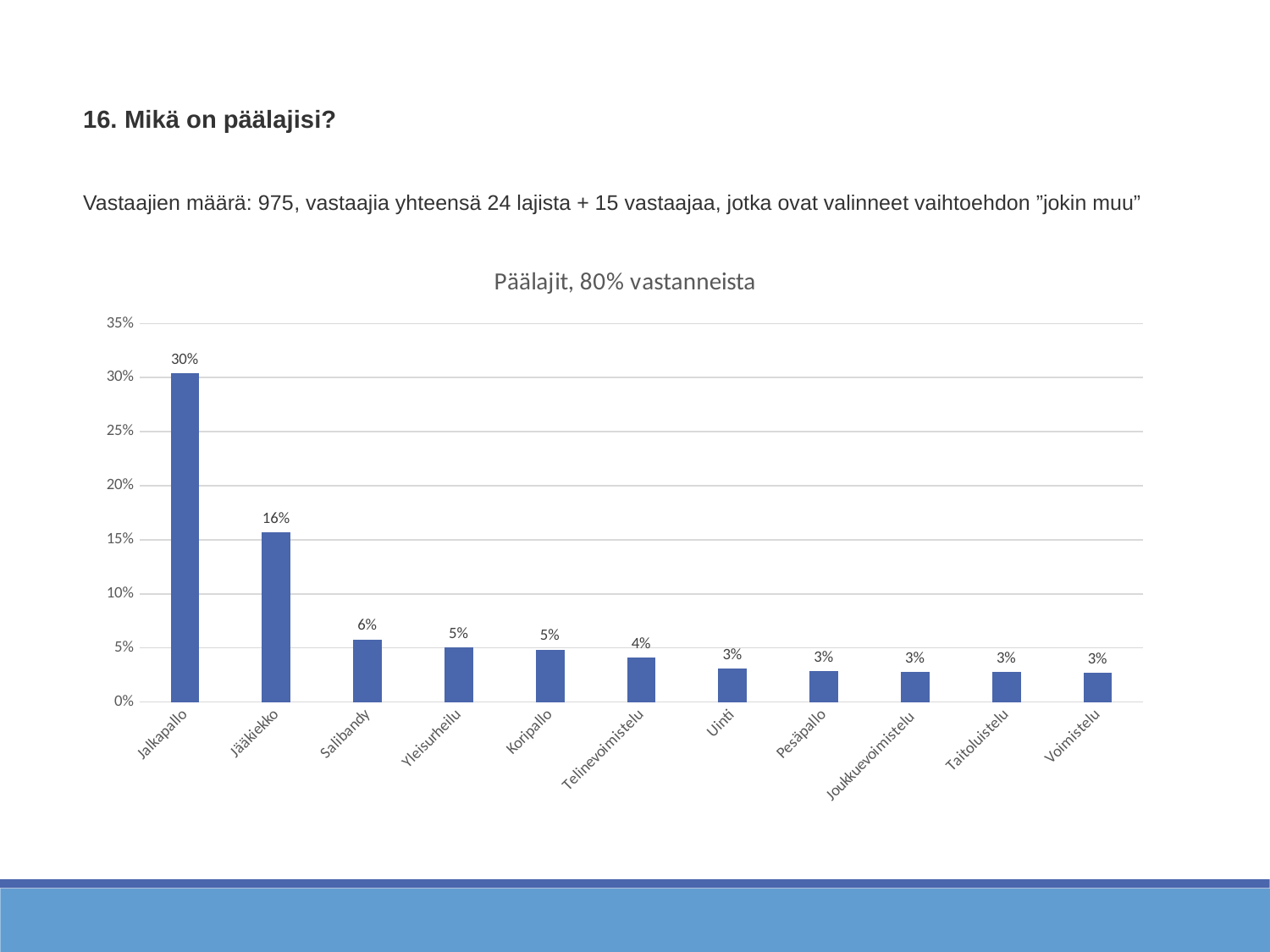
What is the value for Uinti? 3% What is the value for Telinevoimistelu? 4% What is the value for Jalkapallo? 30% What is the value for Jääkiekko? 16% What is the title of the chart? Päälajit, 80% vastanneista Which category has the highest value? Jalkapallo What is the value for Salibandy? 6% What is the difference between the values for Jalkapallo and Jääkiekko? 14% How many categories are shown on the x axis? 11 Is the value for Jääkiekko greater or less than 20%? less What kind of chart is shown on the slide? bar chart Which is larger, the value for Jääkiekko or the value for Salibandy? Jääkiekko